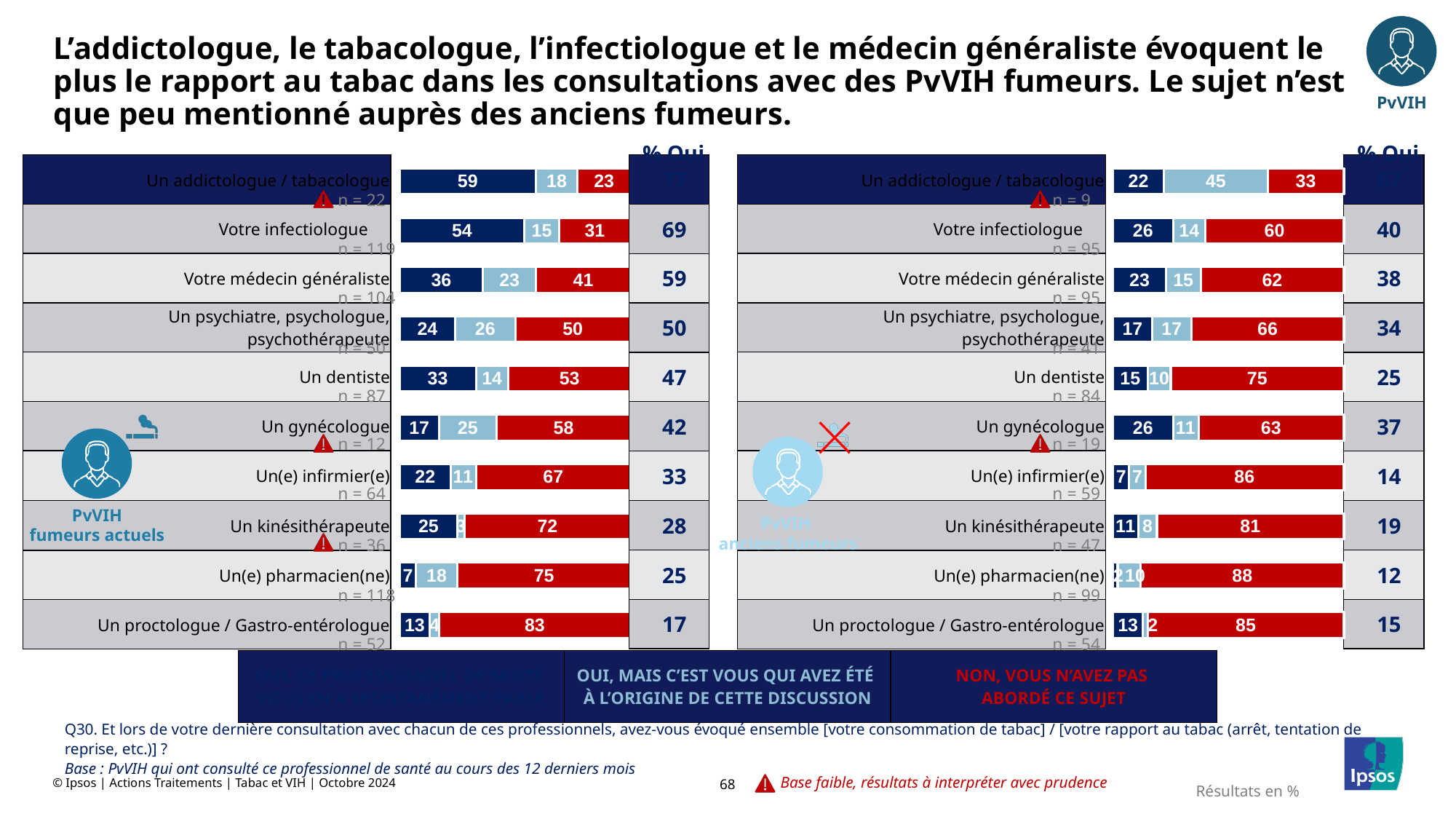
On the left chart (PvVIH fumeurs actuels), what is the difference between the % Oui values for Votre infectiologue and Votre médecin généraliste? 10 What kind of chart is used on the right (PvVIH anciens fumeurs)? Stacked bar chart On the left chart (PvVIH fumeurs actuels), what is the % Oui value for Votre infectiologue? 69 How many professionals are listed on the left chart (PvVIH fumeurs actuels)? 10 On the right chart (PvVIH anciens fumeurs), which is larger: the red 'Non' value for Un(e) infirmier(e) or for Un kinésithérapeute? Un(e) infirmier(e) On the right chart (PvVIH anciens fumeurs), what is the % Oui value for Un psychiatre, psychologue, psychothérapeute? 34 On the left chart (PvVIH fumeurs actuels), what is the red 'Non, vous n'avez pas abordé ce sujet' value for Un dentiste? 53 On the right chart (PvVIH anciens fumeurs), what is the red 'Non' value for Un(e) pharmacien(ne)? 88 On the left chart (PvVIH fumeurs actuels), which professional has the highest red 'Non' value? Un proctologue / Gastro-entérologue On the right chart (PvVIH anciens fumeurs), which professional has the lowest % Oui value? Un(e) pharmacien(ne) How many series does the legend at the bottom of the slide list? 3 On the left chart (PvVIH fumeurs actuels), what is the total of the three segments for Un gynécologue? 100